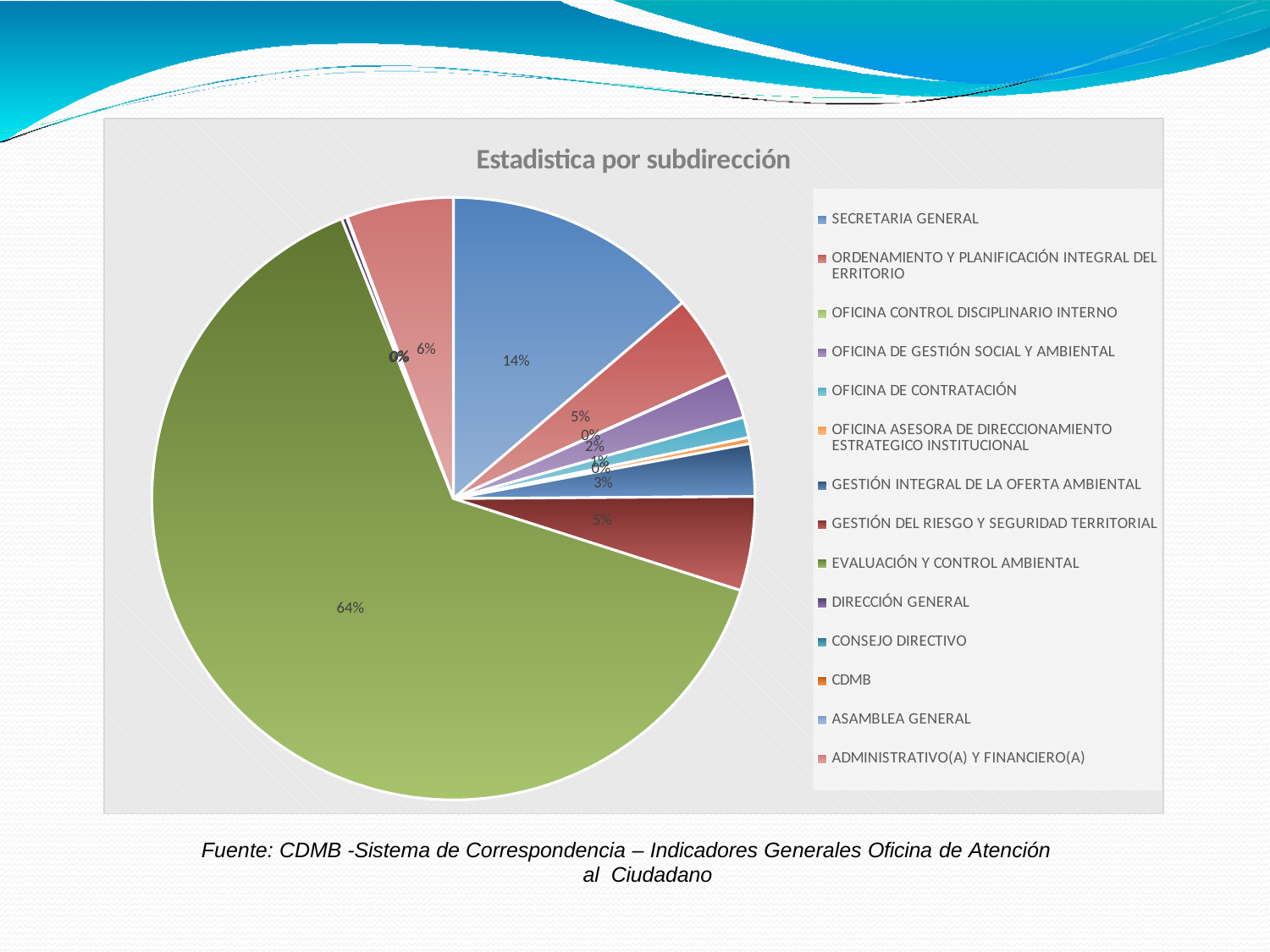
How many categories does the legend list? 14 What is the difference in percentage points between SECRETARIA GENERAL and GESTIÓN INTEGRAL DE LA OFERTA AMBIENTAL? 11 percentage points What is the value shown for ADMINISTRATIVO(A) Y FINANCIERO(A)? 6% What is the difference in percentage points between EVALUACIÓN Y CONTROL AMBIENTAL and SECRETARIA GENERAL? 50 percentage points Which is larger, the share for SECRETARIA GENERAL or the share for ADMINISTRATIVO(A) Y FINANCIERO(A)? SECRETARIA GENERAL What is the value shown for SECRETARIA GENERAL? 14% Which category has the largest share of the pie? EVALUACIÓN Y CONTROL AMBIENTAL What percentage of the pie does EVALUACIÓN Y CONTROL AMBIENTAL represent? 64% What is the title of the chart? Estadistica por subdirección What is the value shown for OFICINA DE GESTIÓN SOCIAL Y AMBIENTAL? 2% What kind of chart is shown on the slide? Pie chart What is the value shown for GESTIÓN INTEGRAL DE LA OFERTA AMBIENTAL? 3%